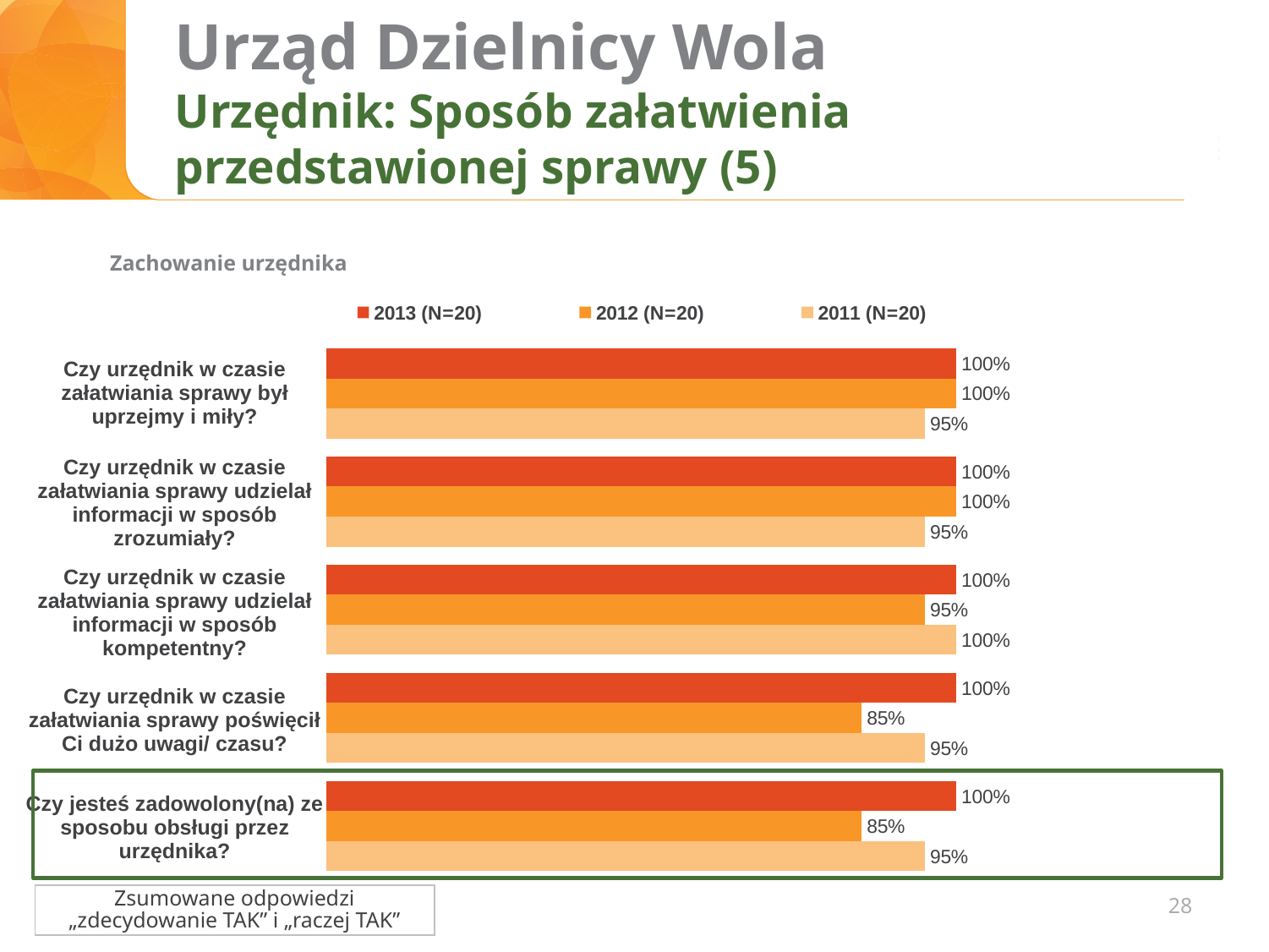
Which series has the lowest value for "Czy urzędnik w czasie załatwiania sprawy poświęcił Ci dużo uwagi/ czasu?"? 2012 (N=20) For "Czy urzędnik w czasie załatwiania sprawy udzielał informacji w sposób kompetentny?", which is larger: the 2012 (N=20) value or the 2011 (N=20) value? 2011 (N=20) What is the 2013 (N=20) value for "Czy jesteś zadowolony(na) ze sposobu obsługi przez urzędnika?"? 100% What is the difference between the 2013 (N=20) and 2012 (N=20) values for "Czy jesteś zadowolony(na) ze sposobu obsługi przez urzędnika?"? 15% What is the subtitle shown above the chart's legend? Zachowanie urzędnika How many series does the legend list? 3 What is the 2012 (N=20) value for "Czy urzędnik w czasie załatwiania sprawy udzielał informacji w sposób kompetentny?"? 95% What is the 2012 (N=20) value for "Czy urzędnik w czasie załatwiania sprawy poświęcił Ci dużo uwagi/ czasu?"? 85% What is the difference between the 2011 (N=20) and 2012 (N=20) values for "Czy urzędnik w czasie załatwiania sprawy poświęcił Ci dużo uwagi/ czasu?"? 10% What kind of chart is shown on the slide? Bar chart How many question categories are shown on the chart? 5 What is the 2011 (N=20) value for "Czy urzędnik w czasie załatwiania sprawy był uprzejmy i miły?"? 95%